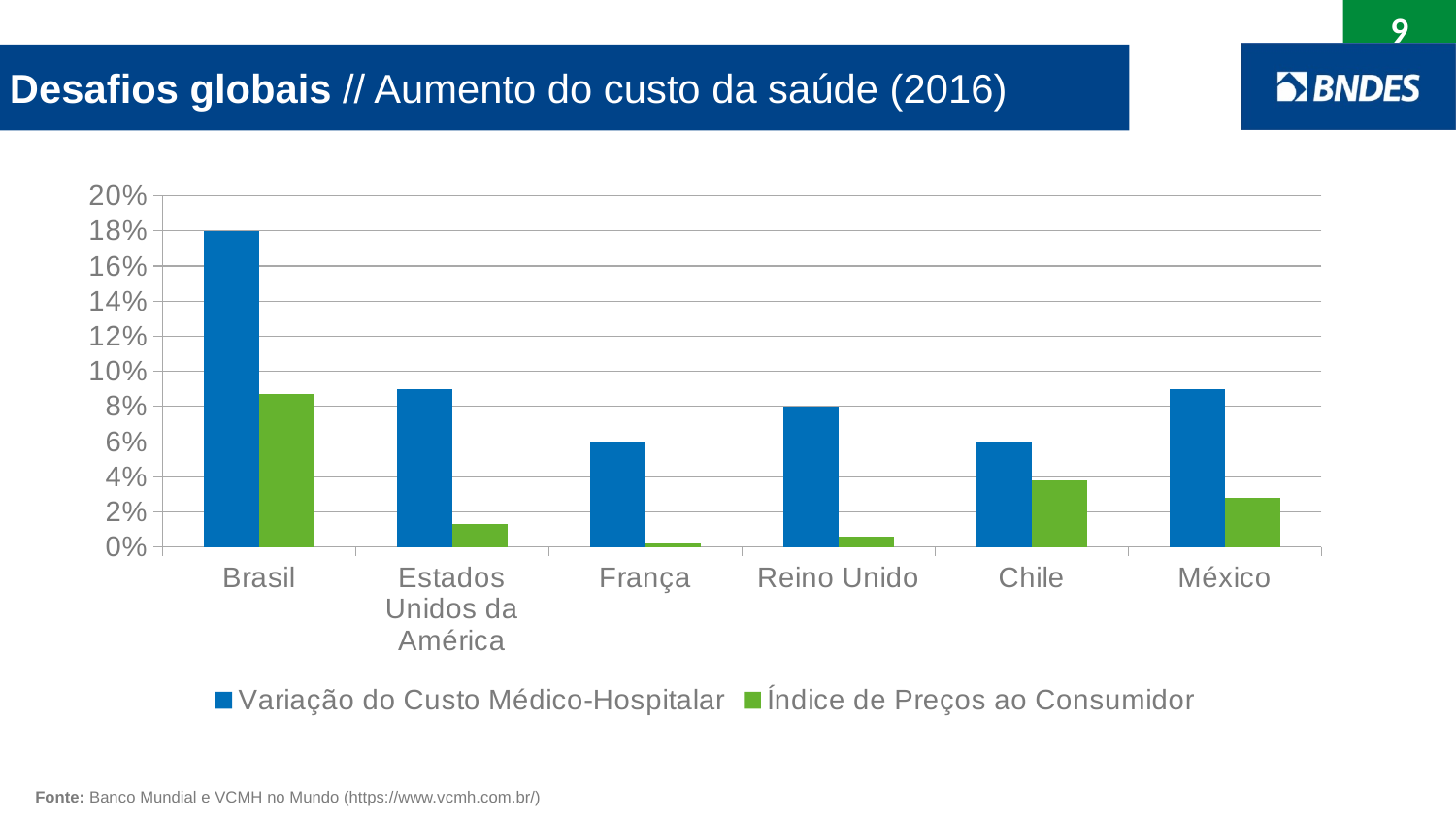
Is the value of Variação do Custo Médico-Hospitalar for Brasil greater or less than 16%? greater How many countries are shown on the x axis of the chart? 6 Which country has the highest value for Índice de Preços ao Consumidor? Brasil Is the value of Variação do Custo Médico-Hospitalar for Reino Unido greater or less than 10%? less How many series does the chart legend list? 2 Which is larger: Variação do Custo Médico-Hospitalar for Brasil or for Estados Unidos da América? Brasil Which country has the lowest value for Índice de Preços ao Consumidor? França Which series is shown in green in the chart legend? Índice de Preços ao Consumidor Is the value of Índice de Preços ao Consumidor for Estados Unidos da América greater or less than 2%? less Which country has the highest value for Variação do Custo Médico-Hospitalar? Brasil What kind of chart is shown on the slide? bar chart